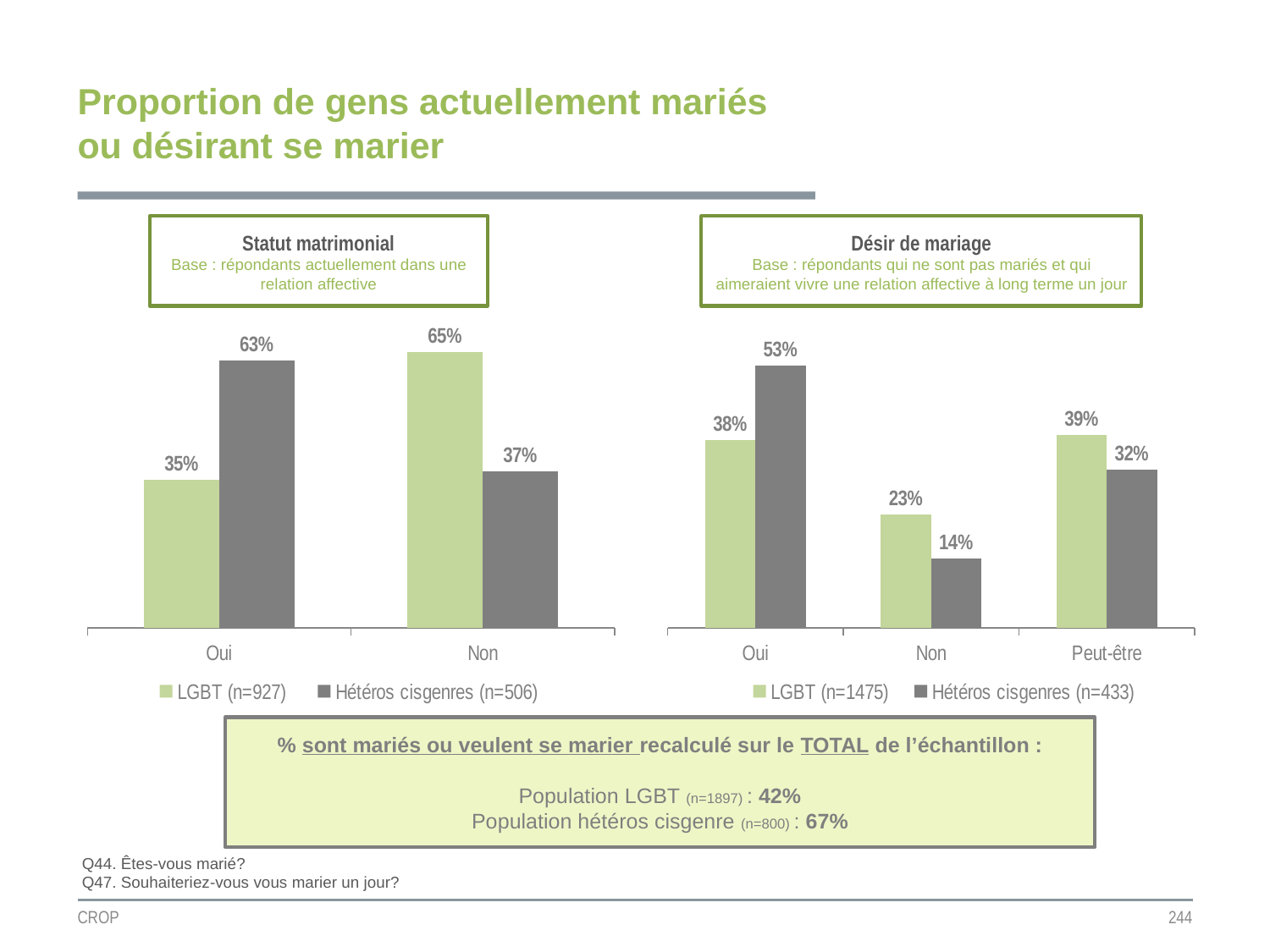
In the 'Désir de mariage' chart, what is the difference between the Hétéros cisgenres (n=433) and LGBT (n=1475) values in the 'Oui' category? 15 percentage points In the 'Désir de mariage' chart, what is the value for Hétéros cisgenres (n=433) in the 'Peut-être' category? 32% What type of chart is the 'Désir de mariage' chart? Bar chart How many series does the legend of the 'Statut matrimonial' chart list? 2 In the 'Désir de mariage' chart, which category has the lowest value for Hétéros cisgenres (n=433)? Non In the 'Désir de mariage' chart, what is the value for LGBT (n=1475) in the 'Non' category? 23% How many categories are shown on the x axis of the 'Désir de mariage' chart? 3 In the 'Désir de mariage' chart, which category has the highest value for LGBT (n=1475)? Peut-être In the 'Statut matrimonial' chart, what is the difference between the Hétéros cisgenres (n=506) and LGBT (n=927) values in the 'Oui' category? 28 percentage points In the 'Statut matrimonial' chart, what is the value for LGBT (n=927) in the 'Oui' category? 35% In the 'Statut matrimonial' chart, which series has the larger value in the 'Non' category? LGBT (n=927) In the 'Statut matrimonial' chart, what is the value for Hétéros cisgenres (n=506) in the 'Non' category? 37%